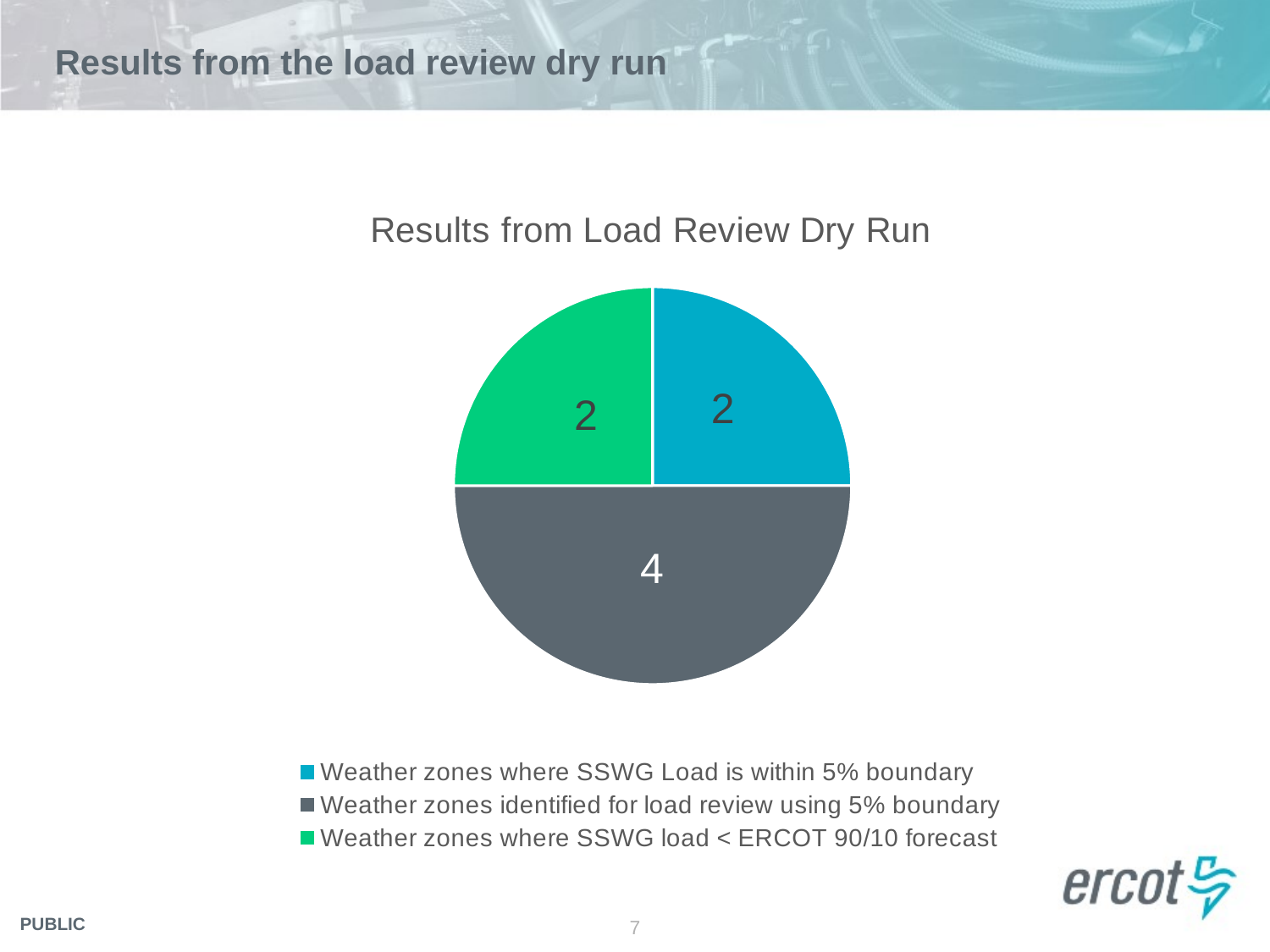
How many slices does the pie chart have? 3 How many entries does the legend list? 3 Which colour represents 'Weather zones where SSWG load < ERCOT 90/10 forecast'? green What type of chart is shown on the slide? pie chart What share of the pie does 'Weather zones identified for load review using 5% boundary' represent? 50% What is the title of the chart? Results from Load Review Dry Run What is the value for 'Weather zones where SSWG Load is within 5% boundary'? 2 What is the value for 'Weather zones where SSWG load < ERCOT 90/10 forecast'? 2 What is the value for 'Weather zones identified for load review using 5% boundary'? 4 What is the total of all slices in the pie chart? 8 What is the difference between the value for 'Weather zones identified for load review using 5% boundary' and the value for 'Weather zones where SSWG Load is within 5% boundary'? 2 Which category has the largest slice of the pie? Weather zones identified for load review using 5% boundary